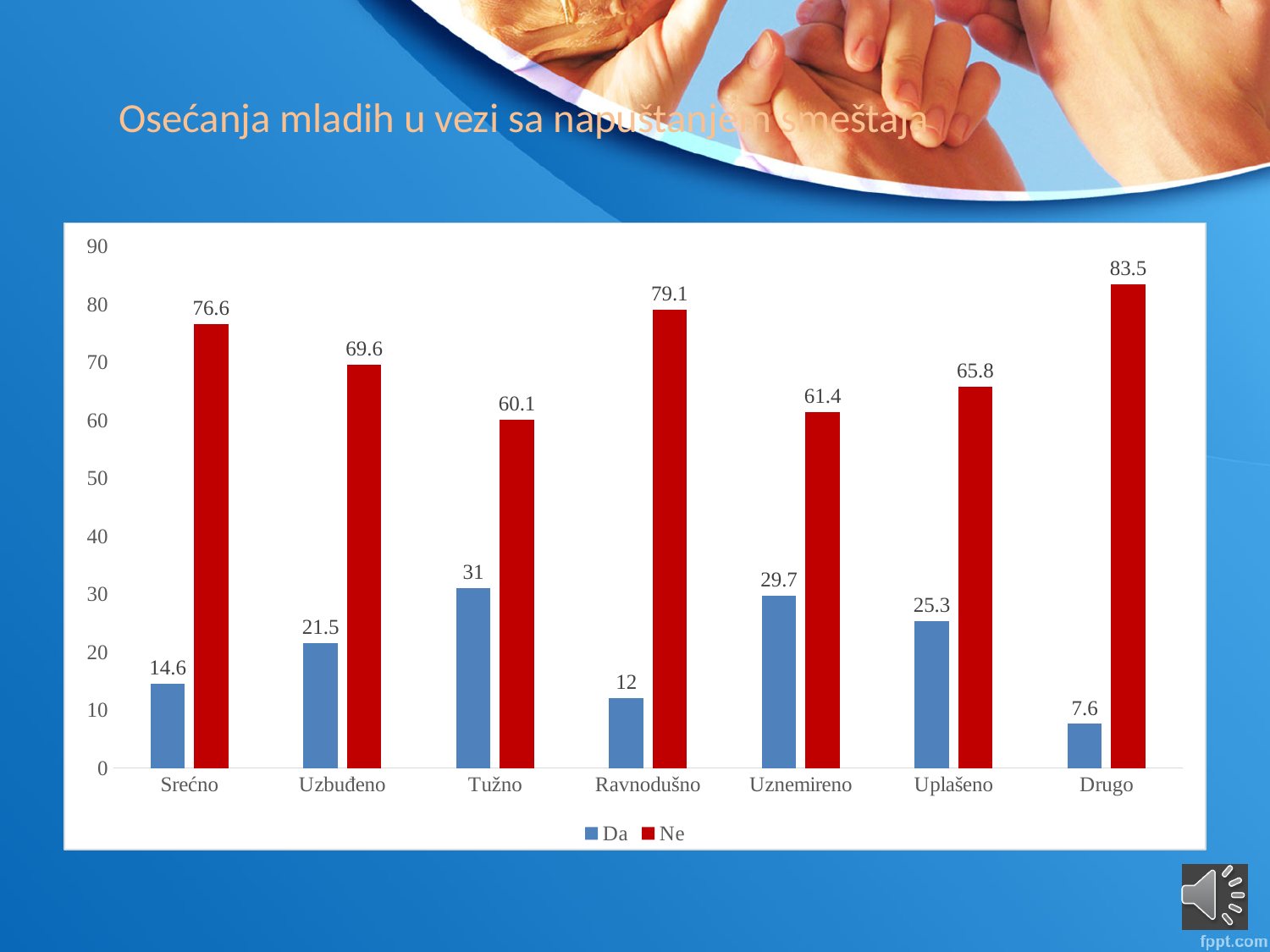
Which category has the lowest "Ne" value? Tužno Which is larger: the "Da" value for Uznemireno or the "Da" value for Uzbuđeno? Uznemireno Which colour represents the "Ne" series in the chart? Red What kind of chart is shown on the slide? Bar chart What is the difference between the "Ne" values for Drugo and Ravnodušno? 4.4 What is the value of the "Da" series for Tužno? 31 Which category has the highest "Da" value? Tužno What is the value of the "Ne" series for Drugo? 83.5 What is the value of the "Da" series for Uplašeno? 25.3 How many series does the legend list? 2 What is the difference between the "Ne" and "Da" values for Srećno? 62 How many categories are shown on the x axis? 7